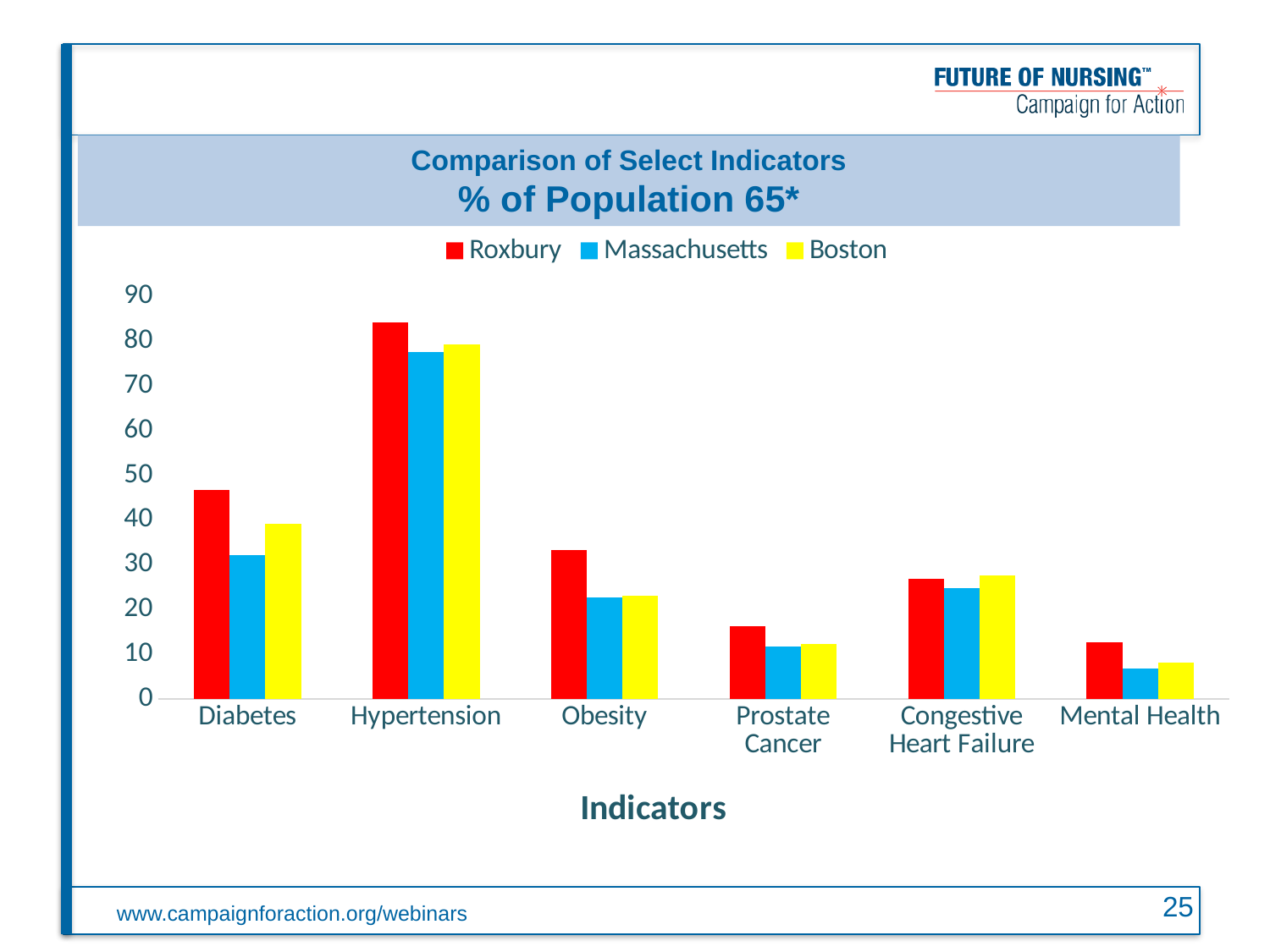
Is the Roxbury value for Hypertension greater or less than 80? greater For which indicator is the Roxbury value highest? Hypertension For which indicator is the Roxbury value lowest? Mental Health What kind of chart is shown on the slide? bar chart For Diabetes, which is larger: the Roxbury value or the Boston value? Roxbury How many series does the legend list? 3 Is the Roxbury value for Diabetes greater or less than 40? greater How many indicators are shown along the x axis? 6 Is the Massachusetts value for Diabetes greater or less than 40? less What is the title of the x axis? Indicators For Obesity, which is larger: the Roxbury value or the Massachusetts value? Roxbury Which colour represents Boston in the legend? yellow